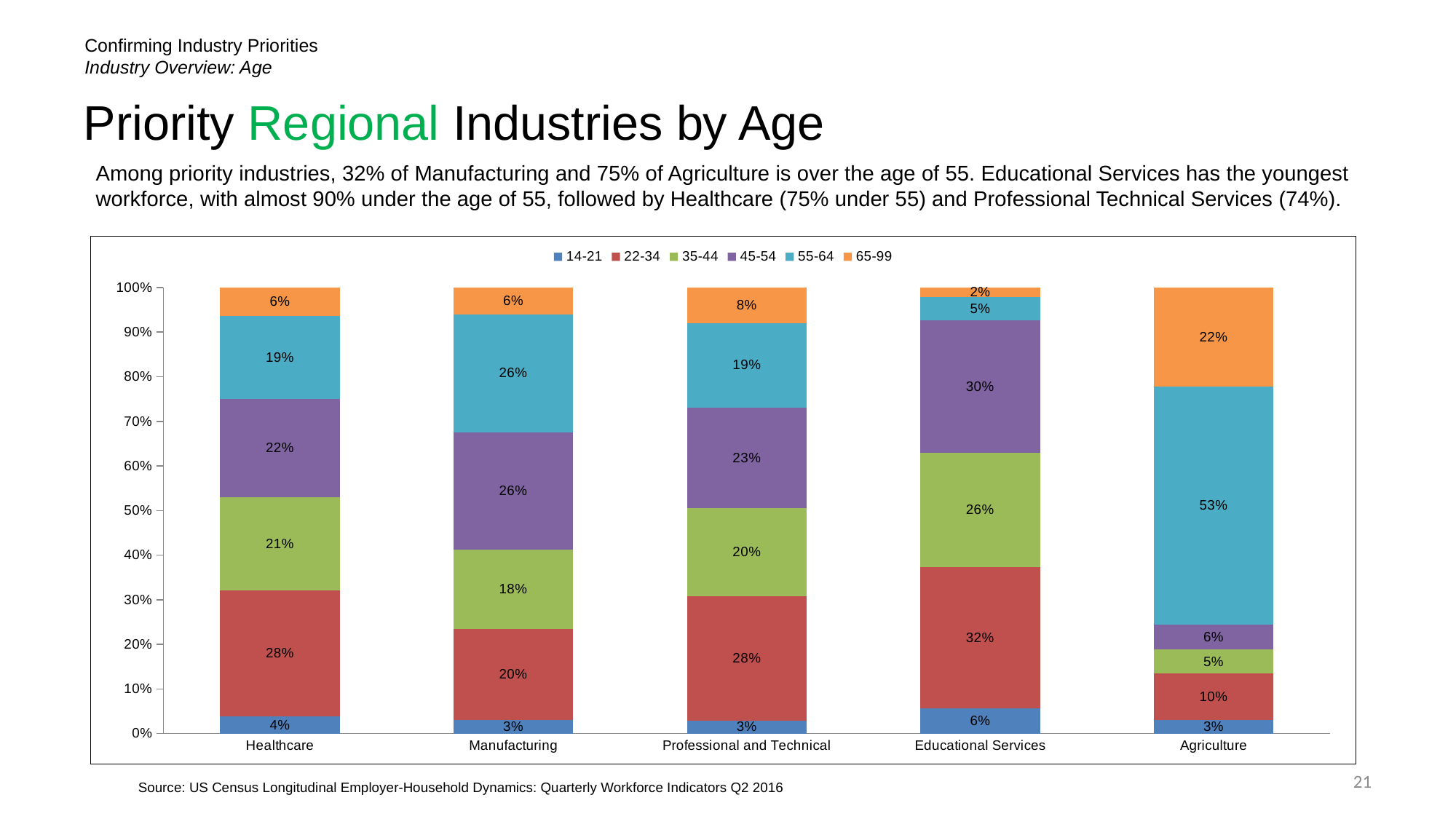
Which industry has the lowest share of workers aged 55-64? Educational Services Which age group is shown in orange in the legend? 65-99 What is the difference between the 22-34 share in Healthcare and the 22-34 share in Manufacturing? 8% Which is larger: the 35-44 share in Educational Services or the 35-44 share in Healthcare? Educational Services What is the value for the 65-99 age group in Professional and Technical? 8% What type of chart is shown on the slide? Stacked bar chart How many age groups does the legend list? 6 What percentage of the Agriculture workforce is in the 55-64 age group? 53% What percentage of the Educational Services workforce is aged 22-34? 32% Which industry has the highest share of workers aged 65-99? Agriculture How many industries are shown on the x axis? 5 What is the value for the 45-54 age group in Manufacturing? 26%